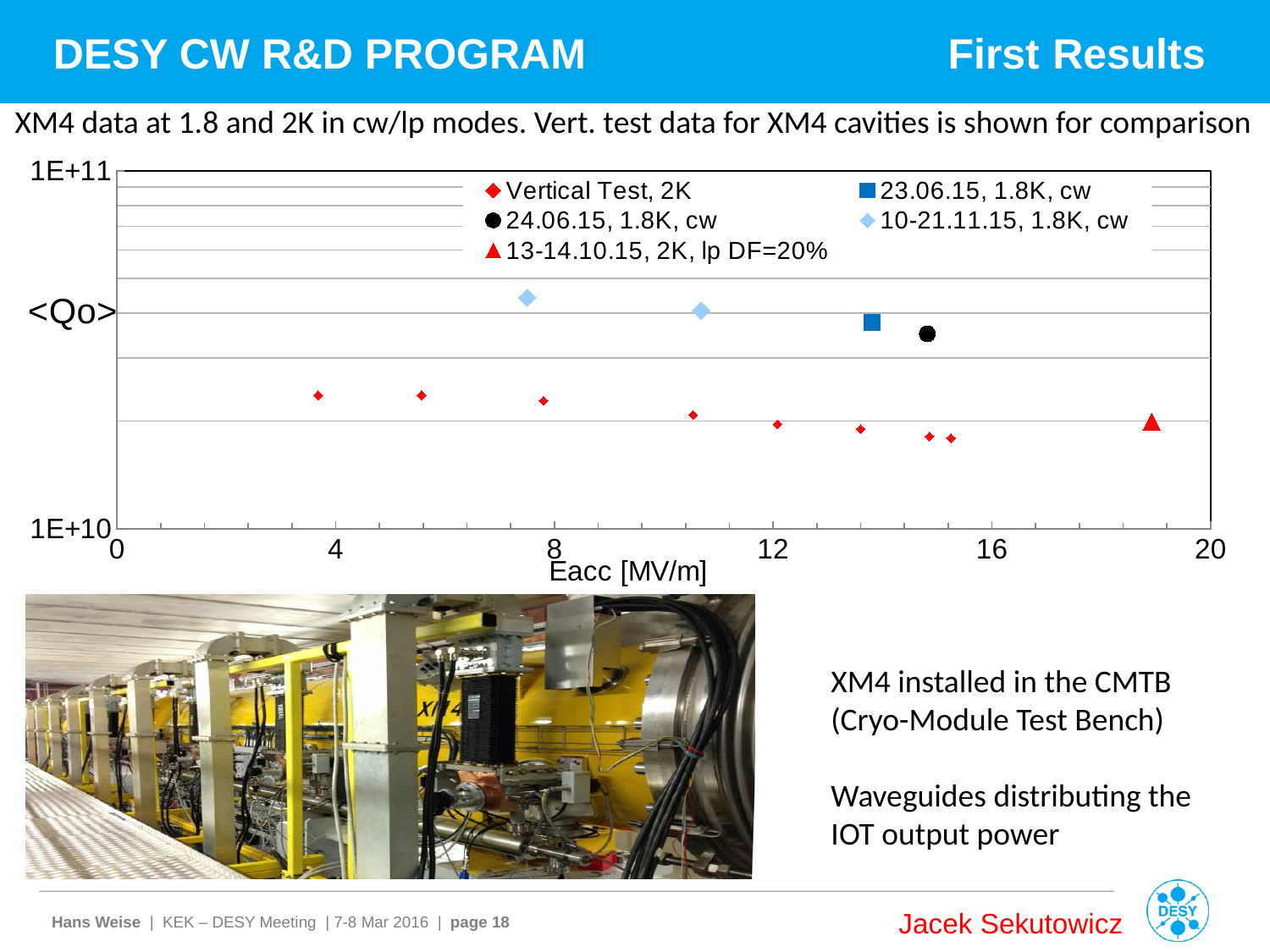
Are the Eacc values of the '10-21.11.15, 1.8K, cw' points greater or less than 12? less Do the 'Vertical Test, 2K' <Qo> values rise or fall as Eacc increases? fall How many data points are plotted for the series '13-14.10.15, 2K, lp DF=20%'? 1 What is the label of the y axis of the chart? <Qo> Is the Eacc value of the '13-14.10.15, 2K, lp DF=20%' point greater or less than 16? greater Which has the higher <Qo>: the '24.06.15, 1.8K, cw' point or the '13-14.10.15, 2K, lp DF=20%' point? 24.06.15, 1.8K, cw What kind of chart is shown on the slide? scatter chart How many data points are plotted for the series '10-21.11.15, 1.8K, cw'? 2 Which series contains the point with the highest <Qo> value on the chart? 10-21.11.15, 1.8K, cw Is the Eacc value of the '23.06.15, 1.8K, cw' point greater or less than 12? greater How many series does the chart legend list? 5 What is the label of the x axis of the chart? Eacc [MV/m]